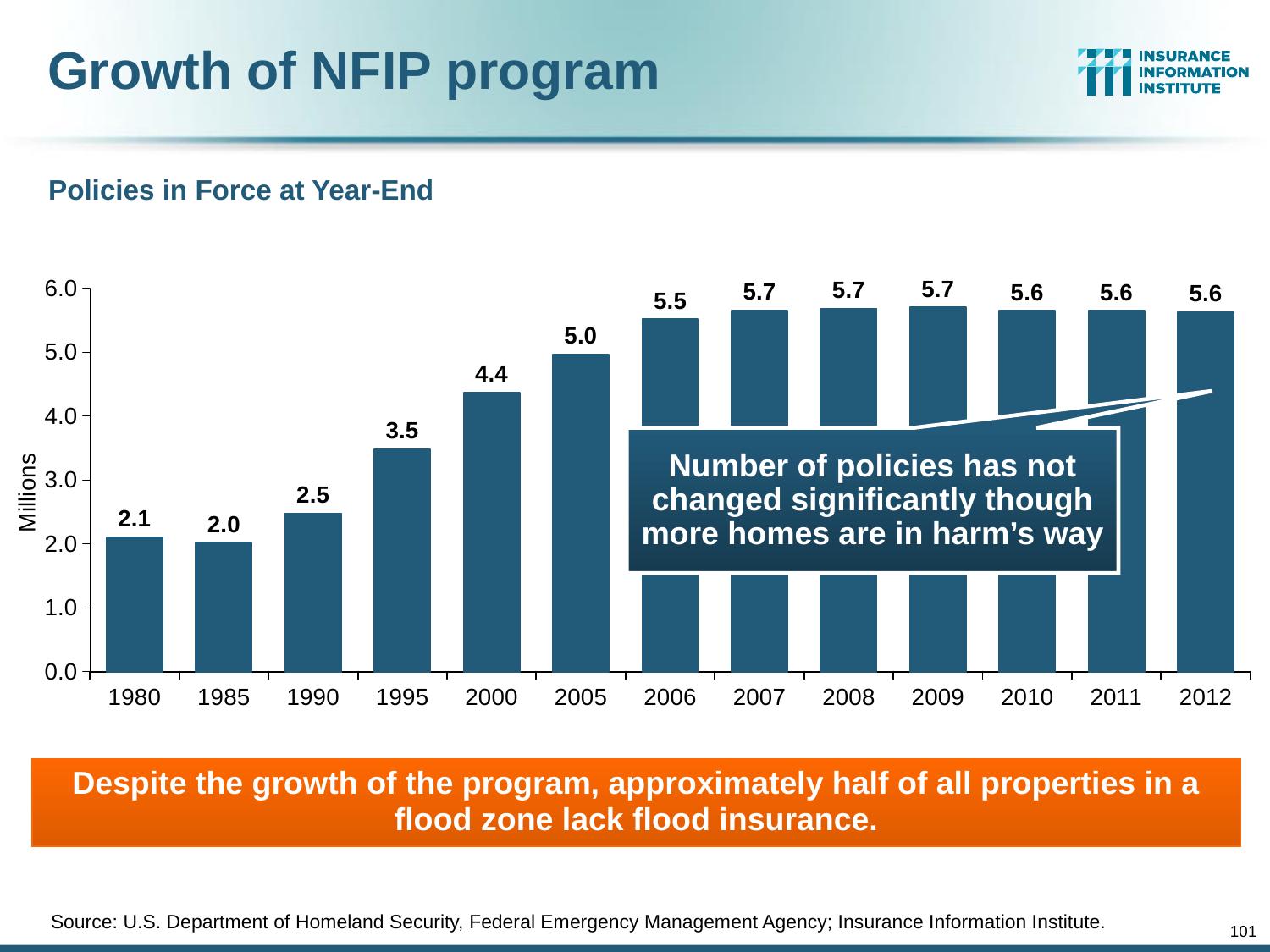
What is the value for 2005? 5.0 What is the value for 1995? 3.5 Is the value for 2006 greater or less than 5.0? greater What is the label on the y axis? Millions Which is larger, the value for 2000 or the value for 1990? 2000 Do the values rise or fall from 1985 to 2007? rise What kind of chart is this? bar chart What is the difference between the values for 2007 and 2010? 0.1 Which year has the lowest value? 1985 What is the value for 2012? 5.6 How many years are shown on the x axis? 13 What is the difference between the values for 2005 and 1980? 2.9